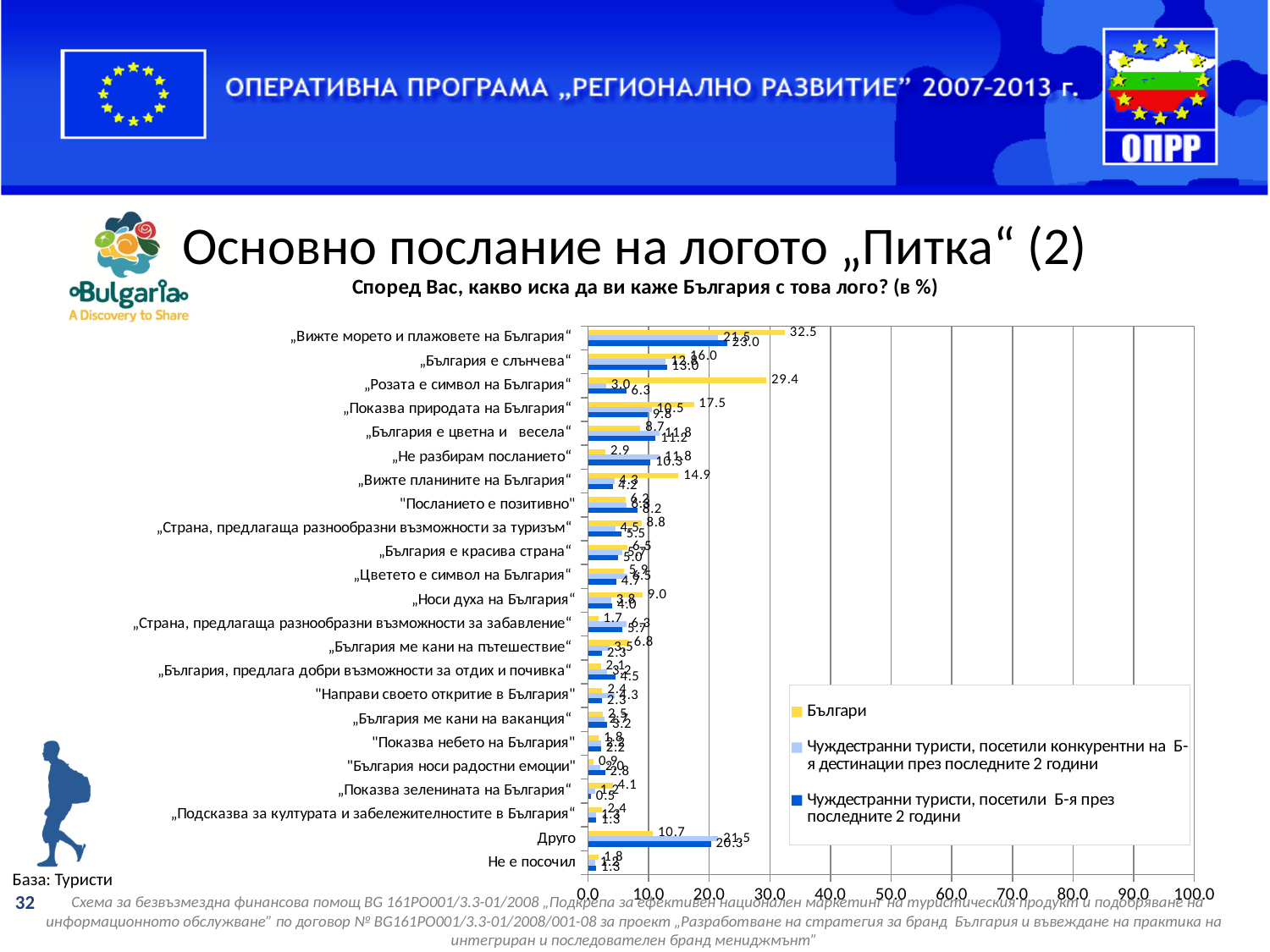
What is the value for „Българи“ for „Показва природата на България“? 17.5 What is the value for „Българи“ for „Розата е символ на България“? 29.4 How many series does the legend list? 3 What kind of chart is shown on the slide? bar chart What is the value for „Българи“ for „Вижте планините на България“? 14.9 What is the value for „Българи“ for „Друго“? 10.7 What is the chart's title? Според Вас, какво иска да ви каже България с това лого? (в %) Which category has the highest value for the „Българи“ series? „Вижте морето и плажовете на България“ How many categories are plotted on the chart? 23 Is the „Българи“ value for „Вижте морето и плажовете на България“ greater or less than 30.0? greater What is the difference between the „Българи“ values for „Вижте морето и плажовете на България“ and „Розата е символ на България“? 3.1 What is the value for „Българи“ for „Вижте морето и плажовете на България“? 32.5